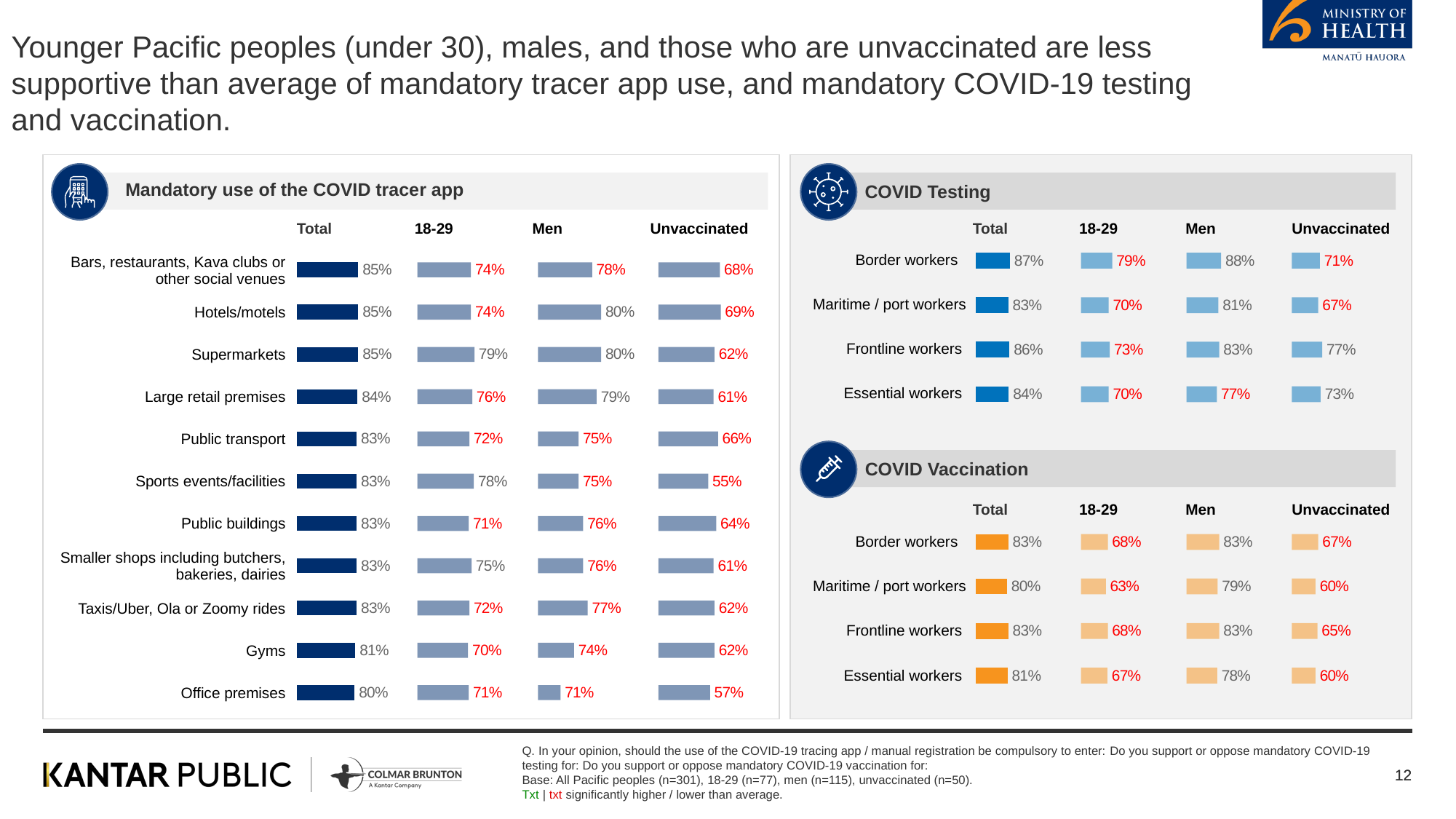
In the 'Mandatory use of the COVID tracer app' chart, how many categories (venue types) are listed? 11 In the 'COVID Vaccination' chart, what is the Unvaccinated value for Maritime / port workers? 60% In the 'COVID Testing' chart, which worker group has the highest Total value? Border workers In the 'Mandatory use of the COVID tracer app' chart, what is the Unvaccinated value for Sports events/facilities? 55% In the 'Mandatory use of the COVID tracer app' chart, what is the Total value for Gyms? 81% In the 'COVID Testing' chart, which is larger for Frontline workers: the 18-29 value or the Unvaccinated value? Unvaccinated (77%) In the 'COVID Vaccination' chart, which worker group has the lowest Total value? Maritime / port workers In the 'Mandatory use of the COVID tracer app' chart, what is the difference between the Total and 18-29 values for Office premises? 9 percentage points In the 'COVID Vaccination' chart, what is the difference between the Total and 18-29 values for Essential workers? 14 percentage points What type of chart is used in the 'COVID Testing' panel? Bar chart In the 'Mandatory use of the COVID tracer app' chart, which category has the lowest Unvaccinated value? Sports events/facilities In the 'COVID Testing' chart, what is the Men value for Border workers? 88%